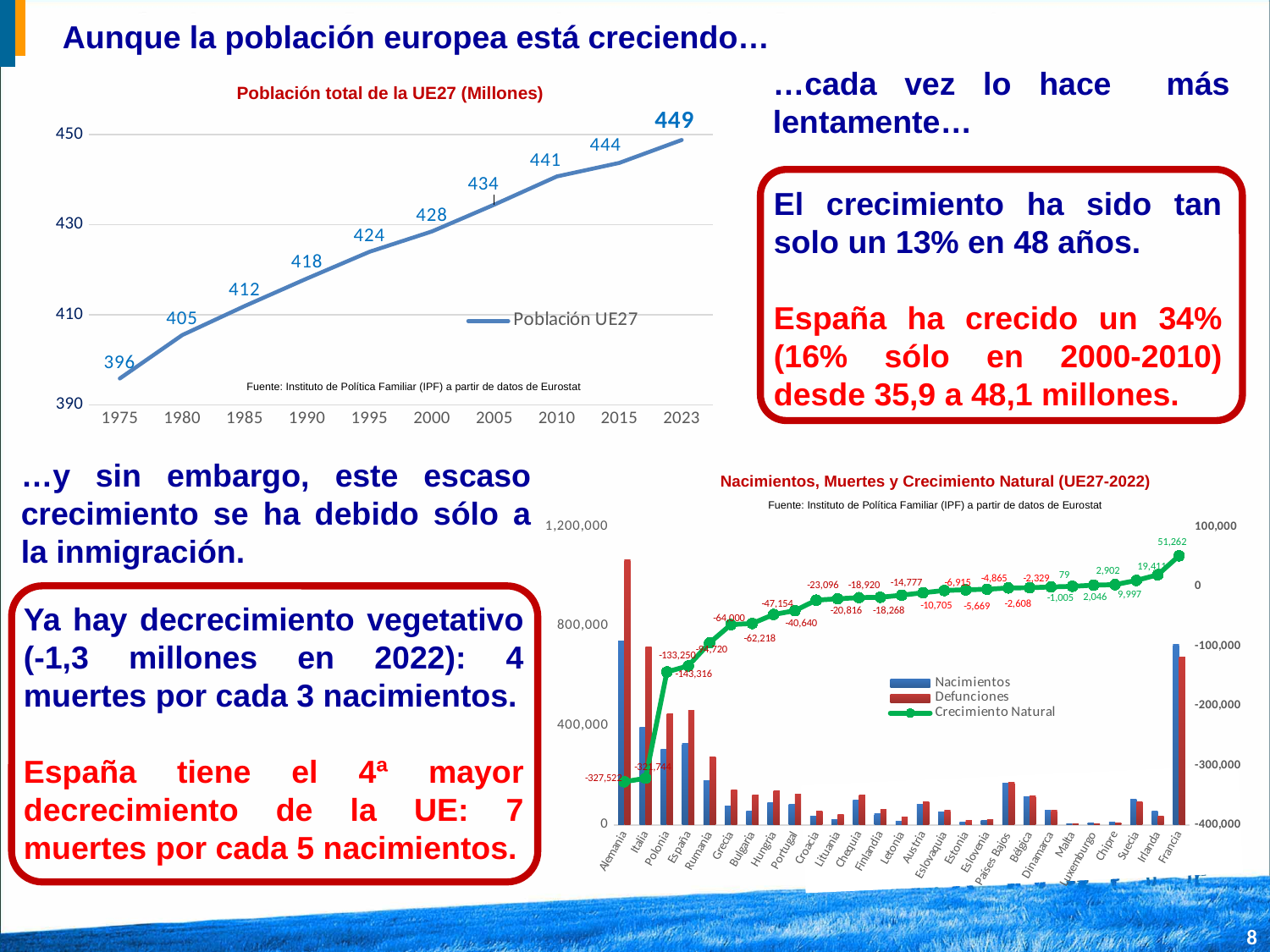
In the chart 'Población total de la UE27 (Millones)', do the values rise or fall from 1975 to 2023? rise In the chart 'Población total de la UE27 (Millones)', what is the difference between the 2023 value and the 1975 value? 53 In the chart 'Nacimientos, Muertes y Crecimiento Natural (UE27-2022)', which country has the highest Crecimiento Natural? Francia In the chart 'Nacimientos, Muertes y Crecimiento Natural (UE27-2022)', what is the Crecimiento Natural value for Francia? 51,262 In the chart 'Población total de la UE27 (Millones)', what is the value for 2000? 428 In the chart 'Población total de la UE27 (Millones)', what is the value for 2023? 449 In the chart 'Nacimientos, Muertes y Crecimiento Natural (UE27-2022)', which country has the lowest Crecimiento Natural? Alemania In the chart 'Nacimientos, Muertes y Crecimiento Natural (UE27-2022)', how many series does the legend list? 3 What kind of chart is 'Población total de la UE27 (Millones)'? line chart In the chart 'Población total de la UE27 (Millones)', how many years are plotted on the x axis? 10 In the chart 'Población total de la UE27 (Millones)', what is the value for 1975? 396 In the chart 'Nacimientos, Muertes y Crecimiento Natural (UE27-2022)', is the Nacimientos value for Alemania greater or less than 400,000? greater